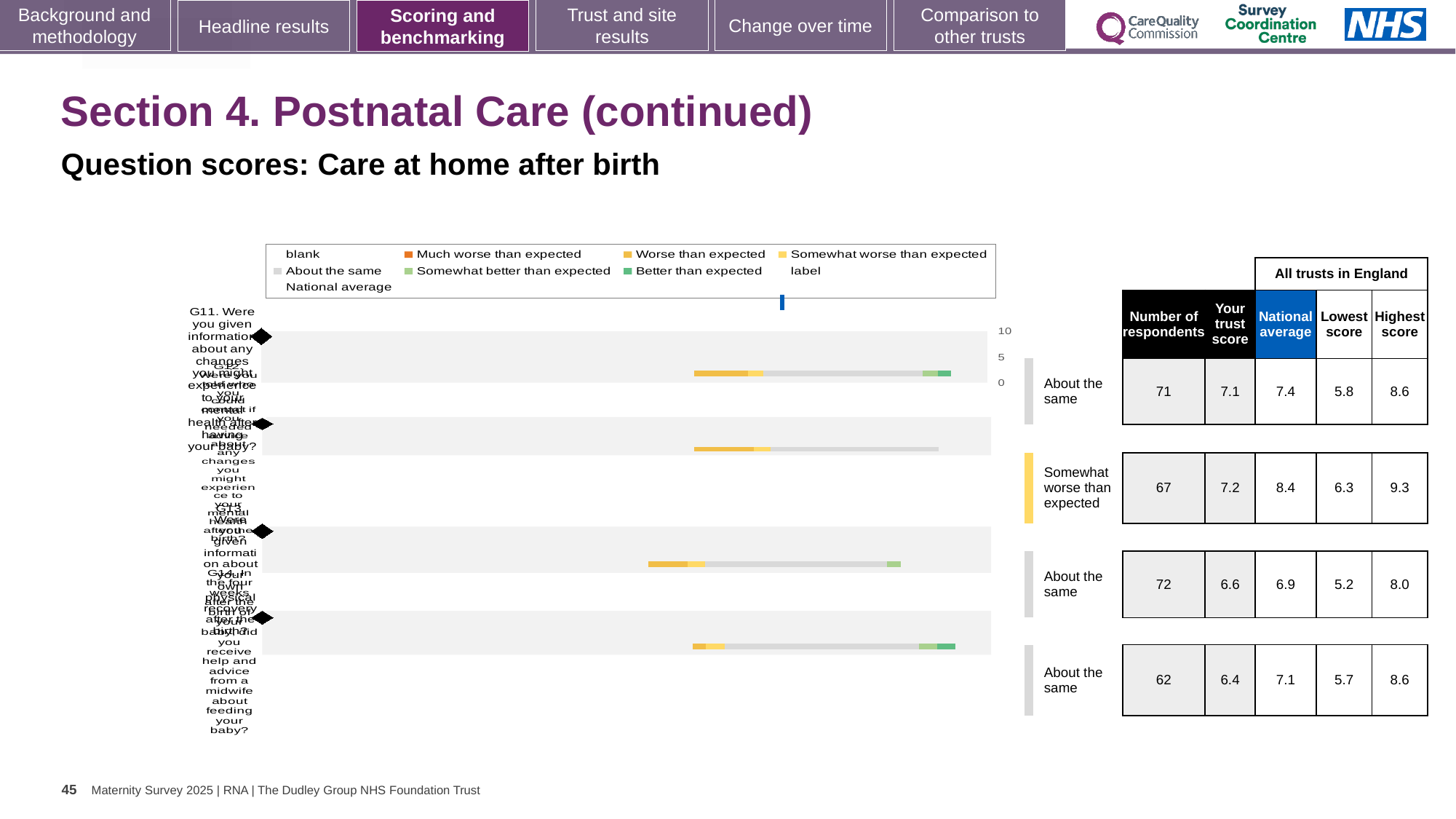
In the chart legend, which colour represents 'Better than expected'? green In the chart legend, which colour represents 'Much worse than expected'? orange How many question bars are plotted in the chart? 4 In the table beside the chart, what is the number of respondents for the first row? 71 Which row of the table has the highest number of respondents? the third row (72) What kind of chart is shown on the slide? bar chart Which row of the chart is rated 'Somewhat worse than expected'? the second row In the table beside the chart, what is the highest score for the fourth row? 8.6 In the table beside the chart, what is the national average for the third row? 6.9 In the table beside the chart, what is the trust score for the second row? 7.2 Which row of the table has the lowest trust score? the fourth row (6.4) In the second row of the table, what is the difference between the national average and the trust score? 1.2